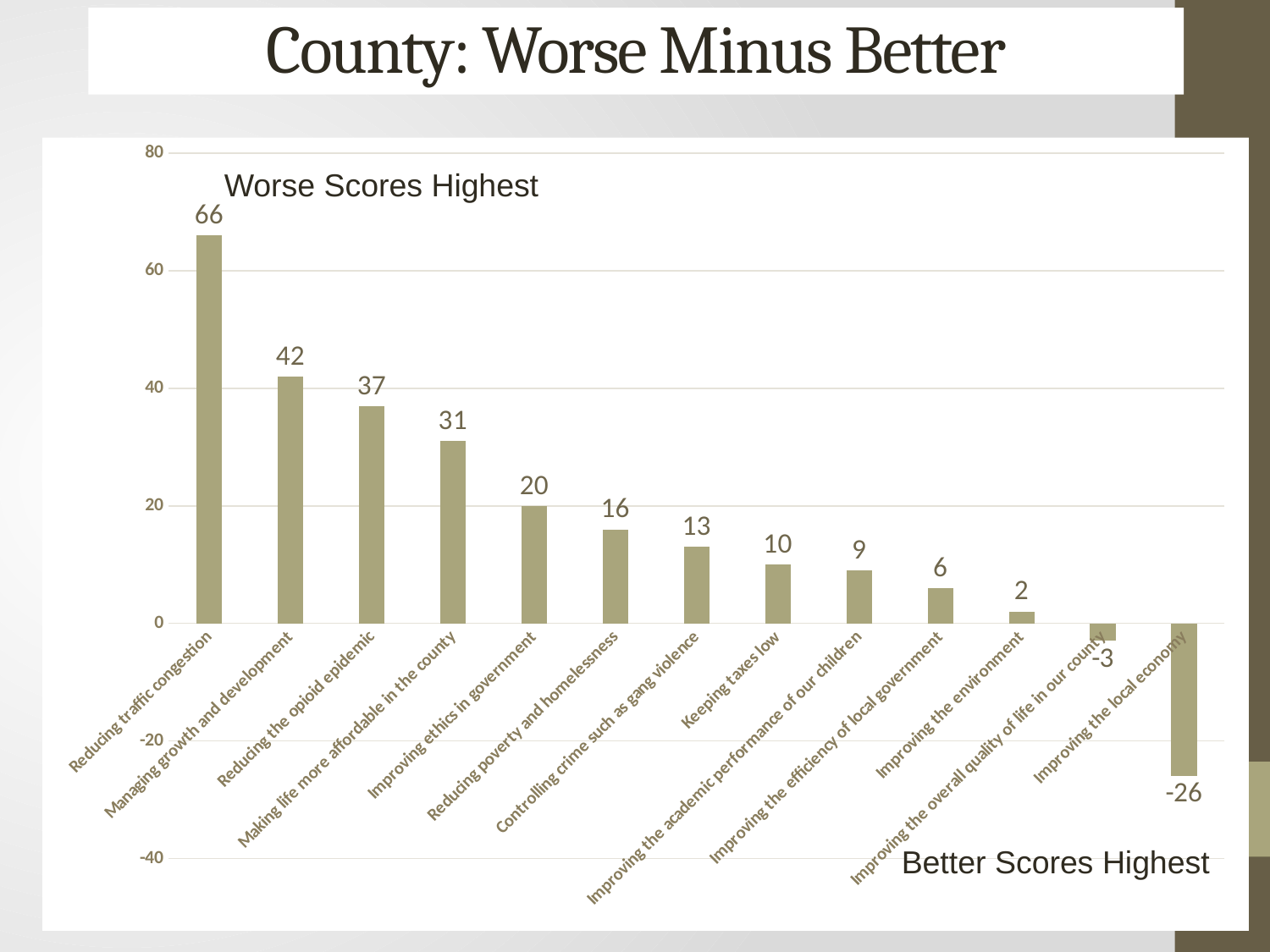
What is the value for Keeping taxes low? 10 Which category has the lowest value? Improving the local economy Is the value for Making life more affordable in the county greater or less than 20? greater What is the difference between the values for Managing growth and development and Reducing the opioid epidemic? 5 Which category has the highest value? Reducing traffic congestion What is the value for Reducing traffic congestion? 66 What kind of chart is shown on the slide? Bar chart What is the value for Improving the local economy? -26 Which is larger, the value for Improving ethics in government or the value for Reducing poverty and homelessness? Improving ethics in government What is the title of the slide? County: Worse Minus Better How many categories are shown in the chart? 13 What is the value for Improving the overall quality of life in our county? -3